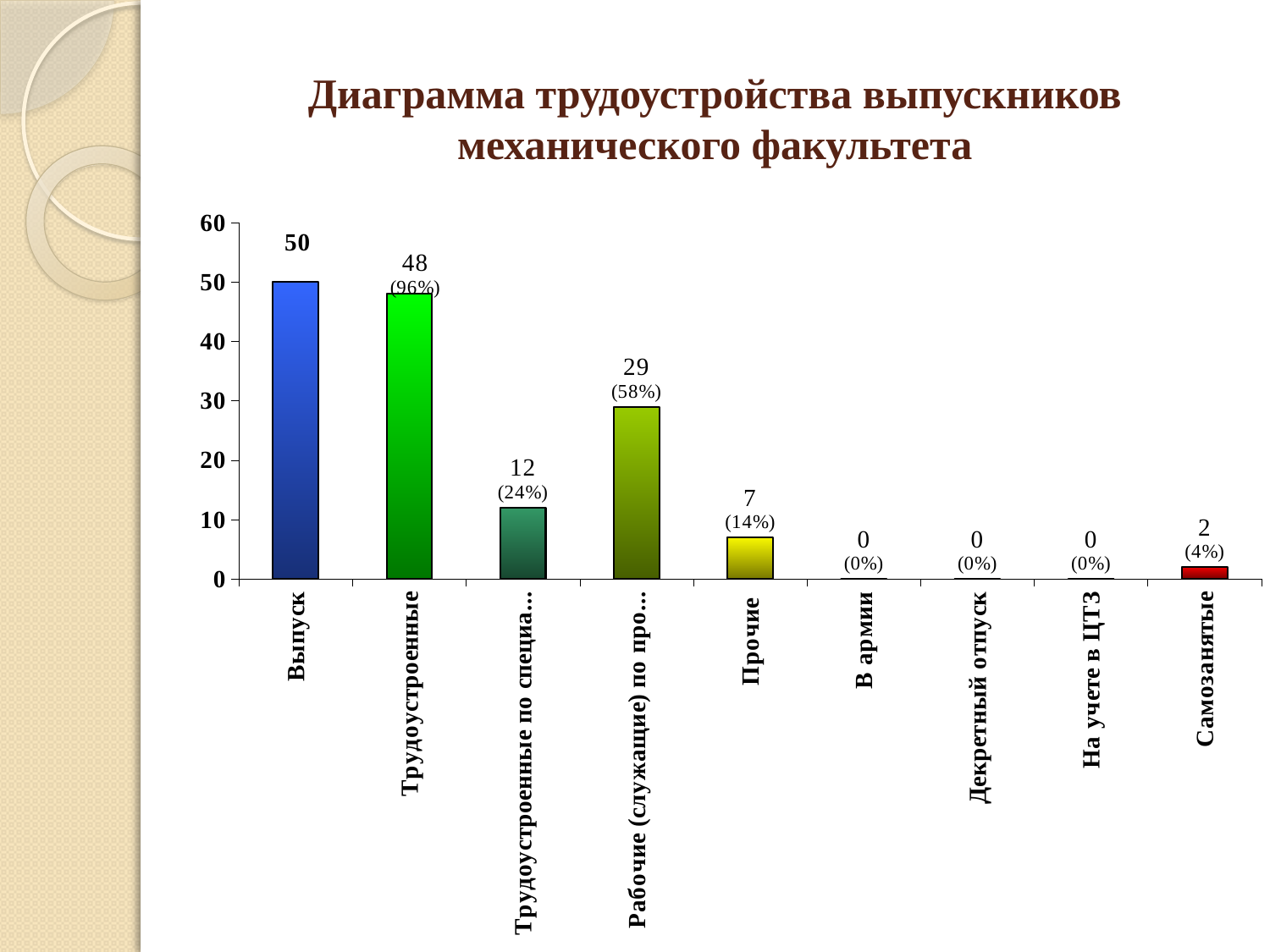
Is the value for Прочие greater or less than 10? less What percentage is shown for Трудоустроенные? 96% What is the value for Прочие? 7 What percentage is shown for Самозанятые? 4% What is the value for Выпуск? 50 Which is larger, the value for Прочие or the value for Самозанятые? Прочие What is the value for Трудоустроенные? 48 What is the value for Самозанятые? 2 What kind of chart is shown on the slide? bar chart What is the difference between the values for Выпуск and Трудоустроенные? 2 Which category has the highest value? Выпуск How many categories are shown on the x axis? 9